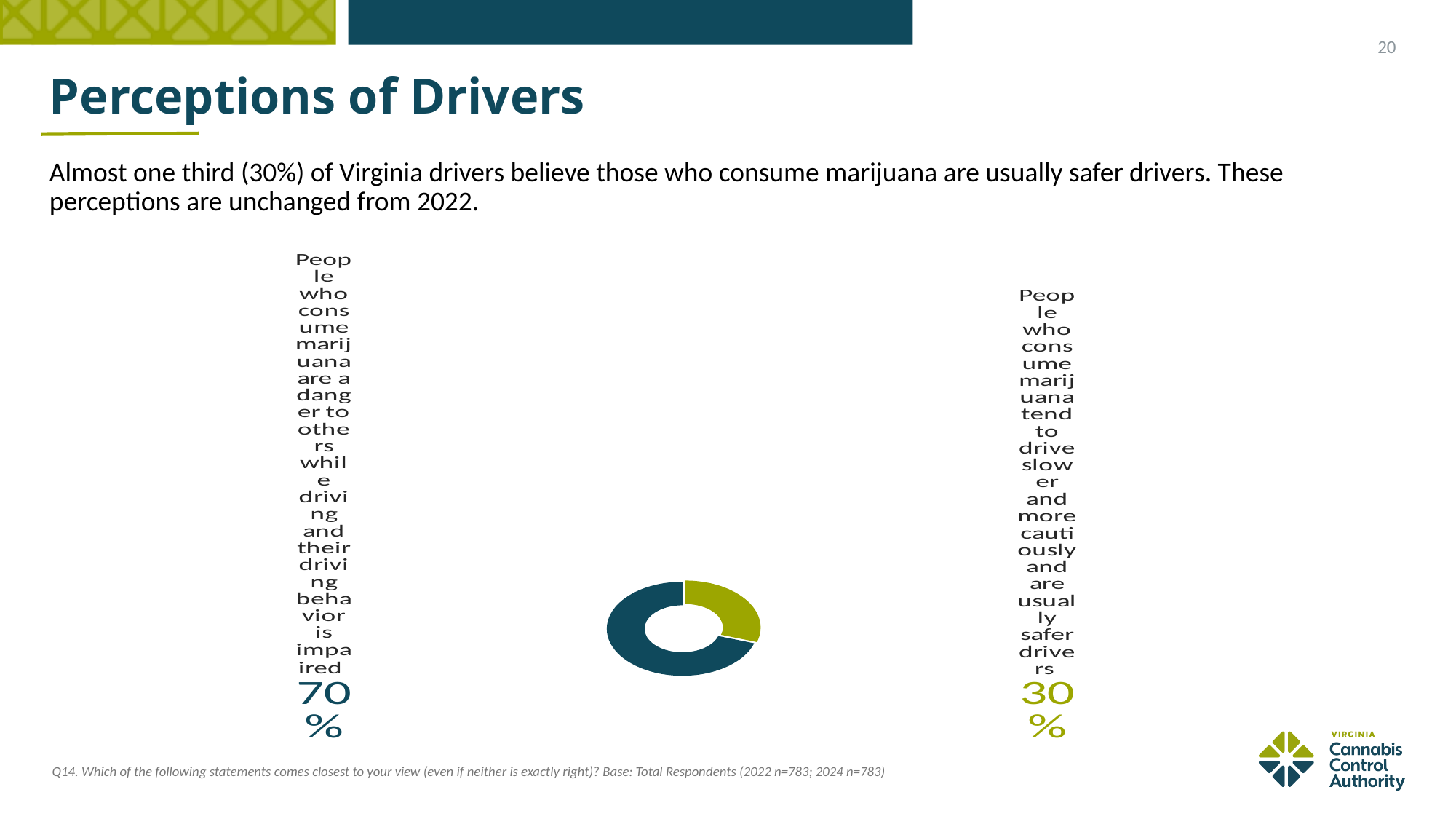
What is the title of the slide containing the chart? Perceptions of Drivers What share of respondents say people who consume marijuana tend to drive slower and more cautiously and are usually safer drivers? 30% What do the two slices of the donut chart add up to? 100% What is the difference in percentage points between the 'danger to others' share and the 'safer drivers' share? 40 percentage points Is the share for 'danger to others while driving' greater or less than 50%? greater Which statement has the larger share of respondents? People who consume marijuana are a danger to others while driving and their driving behavior is impaired What kind of chart is shown on the slide? Donut (pie) chart Which statement has the smaller share of respondents? People who consume marijuana tend to drive slower and more cautiously and are usually safer drivers What share of respondents say people who consume marijuana are a danger to others while driving and their driving behavior is impaired? 70% Is the share for 'safer drivers' greater or less than 50%? less How many slices does the donut chart have? 2 What colour is the slice representing the 30% share? Olive green